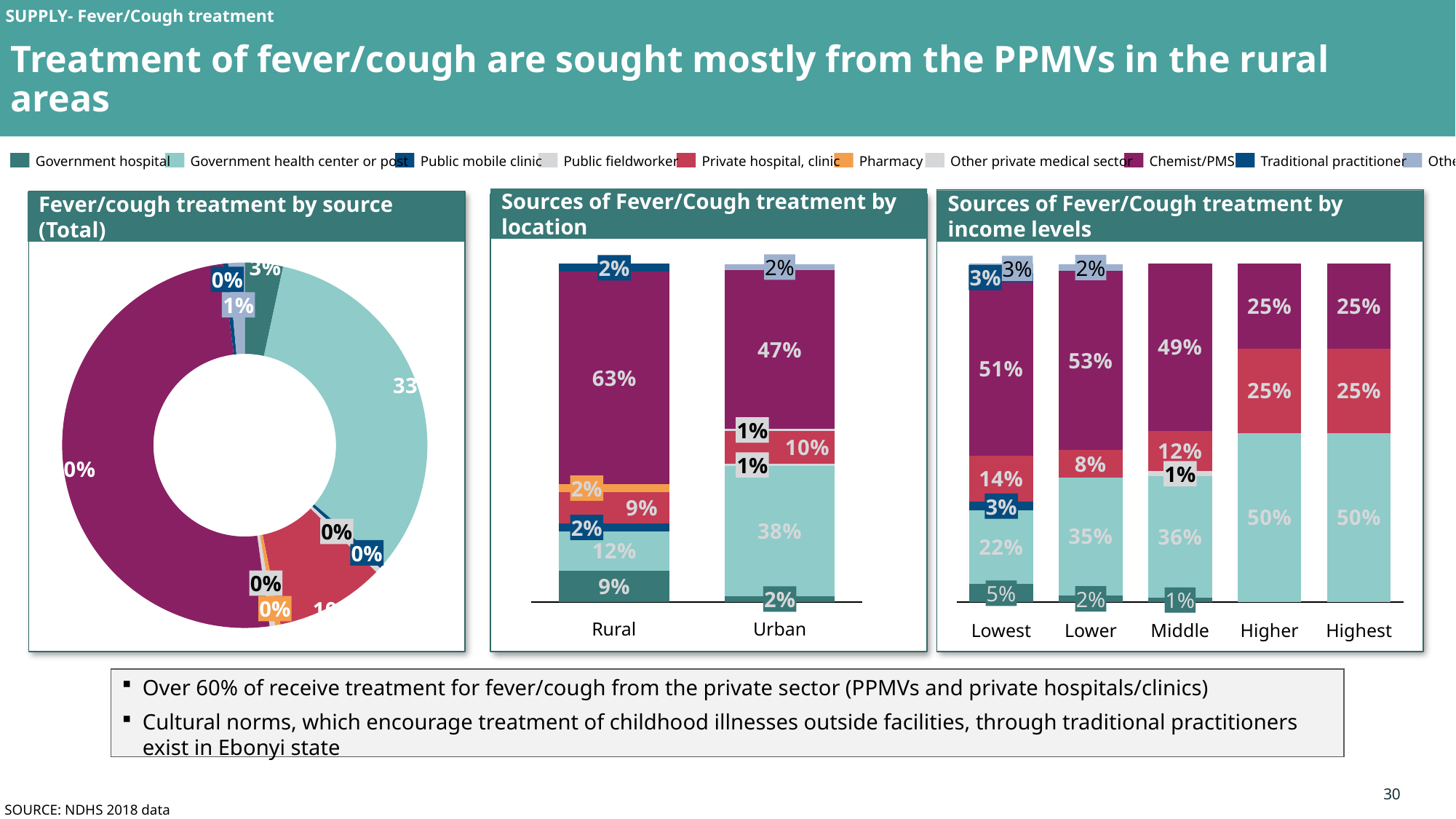
In the 'Sources of Fever/Cough treatment by location' chart, what is the Government hospital share for Rural? 9% In the 'Sources of Fever/Cough treatment by income levels' chart, what is the Private hospital, clinic share for the Lowest income level? 14% In the 'Sources of Fever/Cough treatment by location' chart, what is the Chemist/PMS share for Rural? 63% In the 'Sources of Fever/Cough treatment by location' chart, what is the Chemist/PMS share for Urban? 47% How many income levels are shown in the 'Sources of Fever/Cough treatment by income levels' chart? 5 In the 'Sources of Fever/Cough treatment by income levels' chart, what is the Government health center or post share for the Highest income level? 50% In the 'Sources of Fever/Cough treatment by income levels' chart, which income level has the highest Chemist/PMS share? Lower What kind of chart is 'Fever/cough treatment by source (Total)'? Pie (donut) chart In the 'Sources of Fever/Cough treatment by location' chart, what is the difference between the Chemist/PMS share for Rural and for Urban? 16 percentage points In the 'Sources of Fever/Cough treatment by income levels' chart, what is the Chemist/PMS share for the Lower income level? 53% In the 'Sources of Fever/Cough treatment by income levels' chart, is the Chemist/PMS share larger for the Lowest or the Middle income level? Lowest In the 'Sources of Fever/Cough treatment by location' chart, what is the Government health center or post share for Urban? 38%